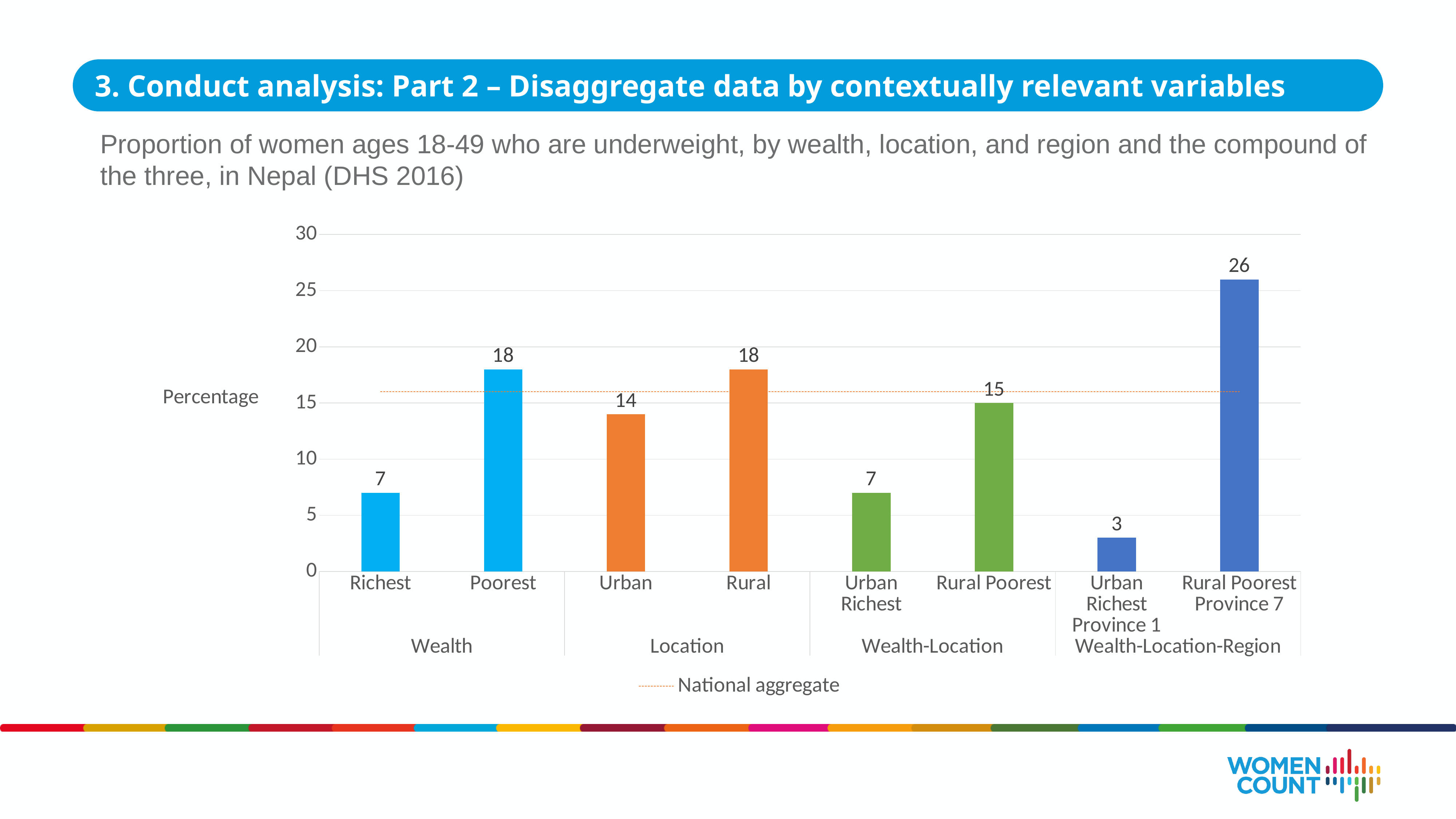
How many bars are plotted in the chart? 8 Is the National aggregate line greater or less than 20? less Which category has the highest value? Rural Poorest Province 7 What is the value for Rural under Location? 18 Which is larger, the value for Rural Poorest or the value for Urban Richest? Rural Poorest Which category has the lowest value? Urban Richest Province 1 What is the value for Rural Poorest Province 7? 26 What is the value for Richest under Wealth? 7 What is the difference between the values for Rural and Urban under Location? 4 What is the value for Urban Richest Province 1? 3 What is the difference between the values for Poorest and Richest under Wealth? 11 What kind of chart is shown on the slide? bar chart